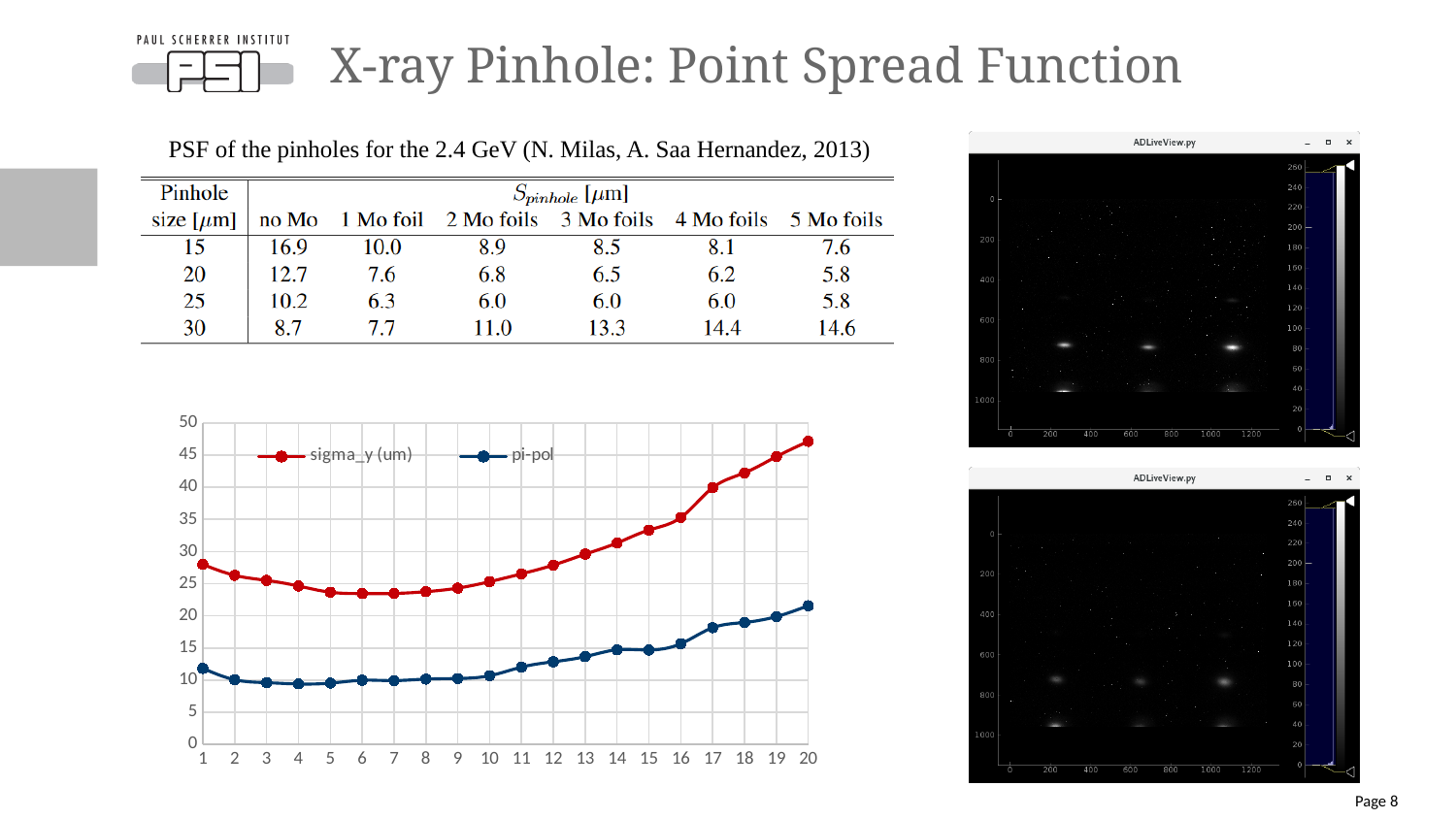
Is the value of pi-pol at x = 10 greater or less than 15? less Is the value of pi-pol at x = 20 greater or less than 20? greater Is the value of sigma_y (um) at x = 1 greater or less than 25? greater Do the sigma_y (um) values rise or fall from x = 10 to x = 20? rise At which x value does the sigma_y (um) series reach its highest value? 20 At x = 10, which series has the higher value, sigma_y (um) or pi-pol? sigma_y (um) What are the two series named in the chart's legend? sigma_y (um) and pi-pol What colour is the sigma_y (um) line in the chart? red How many series does the chart's legend list? 2 How many points are plotted along the x axis for each series? 20 What kind of chart is shown on the slide? line chart